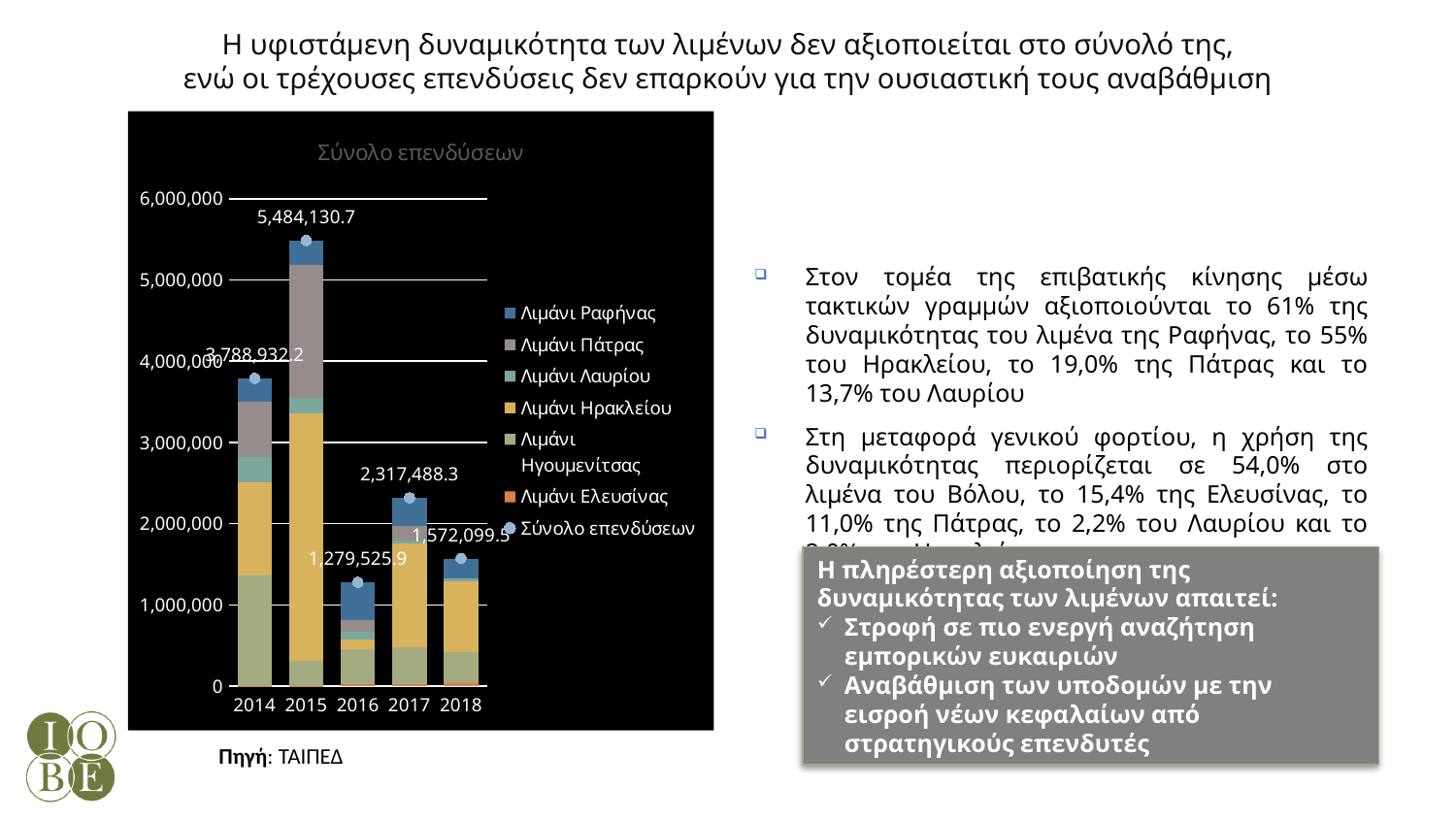
How many entries does the chart legend list? 7 What is the difference between the total investment in 2017 and in 2018? 745,388.8 How many years are shown on the x axis of the chart? 5 Is the total investment for 2017 greater or less than 2,000,000? greater What is the title of the chart? Σύνολο επενδύσεων What is the total investment value shown for 2015? 5,484,130.7 Which year has the lowest total investment? 2016 What is the total investment value shown for 2016? 1,279,525.9 Which year has a larger total investment, 2014 or 2017? 2014 What is the total investment value shown for 2018? 1,572,099.5 Which year has the highest total investment? 2015 What is the difference between the total investment in 2015 and in 2014? 1,695,198.5